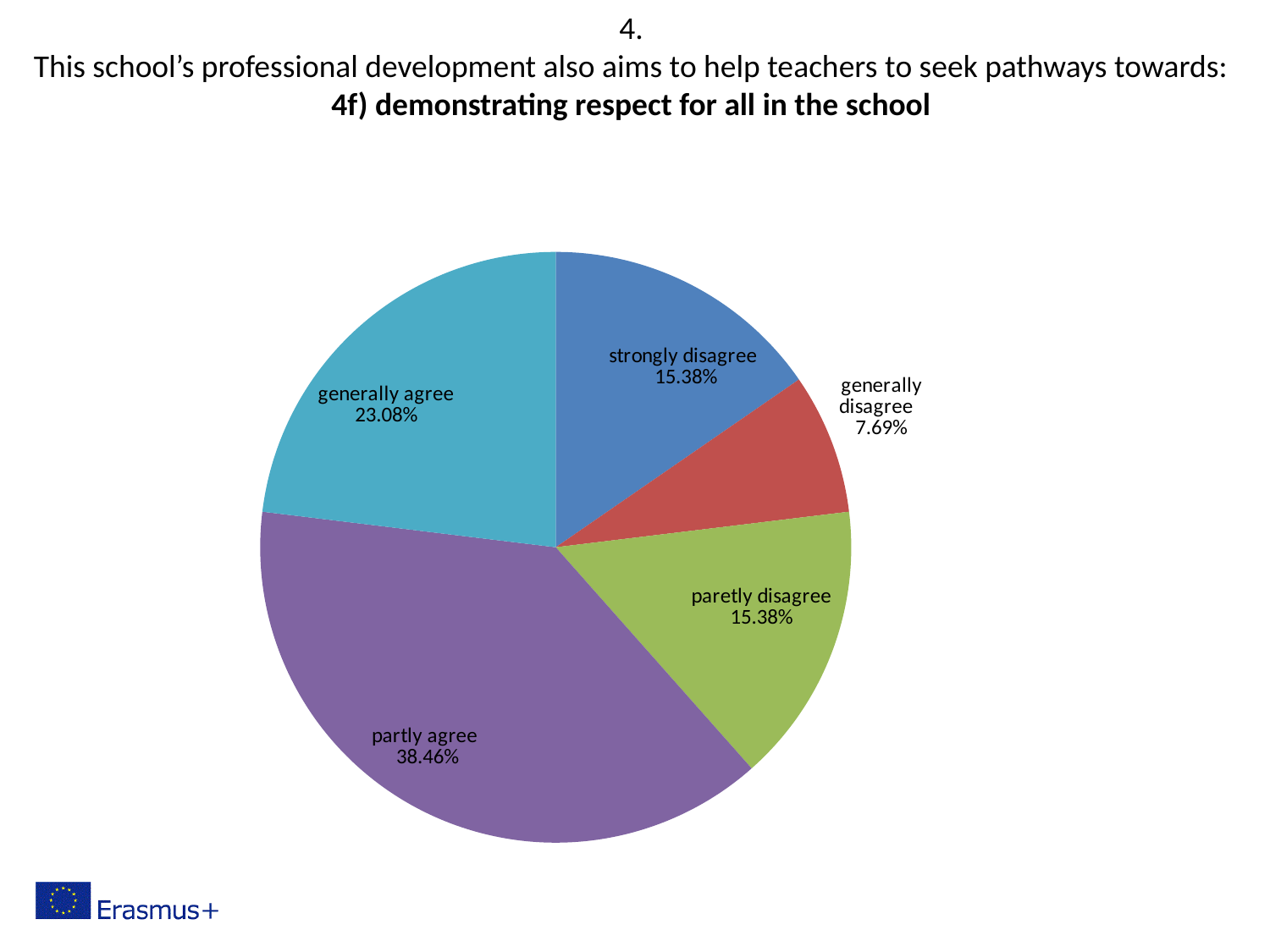
What colour is the "partly agree" slice? purple What share of the pie is labelled "strongly disagree"? 15.38% Which is larger, the "generally agree" slice or the "strongly disagree" slice? generally agree What is the combined share of the "strongly disagree" and "generally disagree" slices? 23.07% What share of the pie is labelled "generally disagree"? 7.69% Which slice of the pie is the largest? partly agree What is the difference between the "partly agree" share and the "generally agree" share? 15.38% What share of the pie is labelled "partly agree"? 38.46% How many slices does the pie chart have? 5 What share of the pie is labelled "generally agree"? 23.08% Which slice of the pie is the smallest? generally disagree What kind of chart is shown on the slide? pie chart